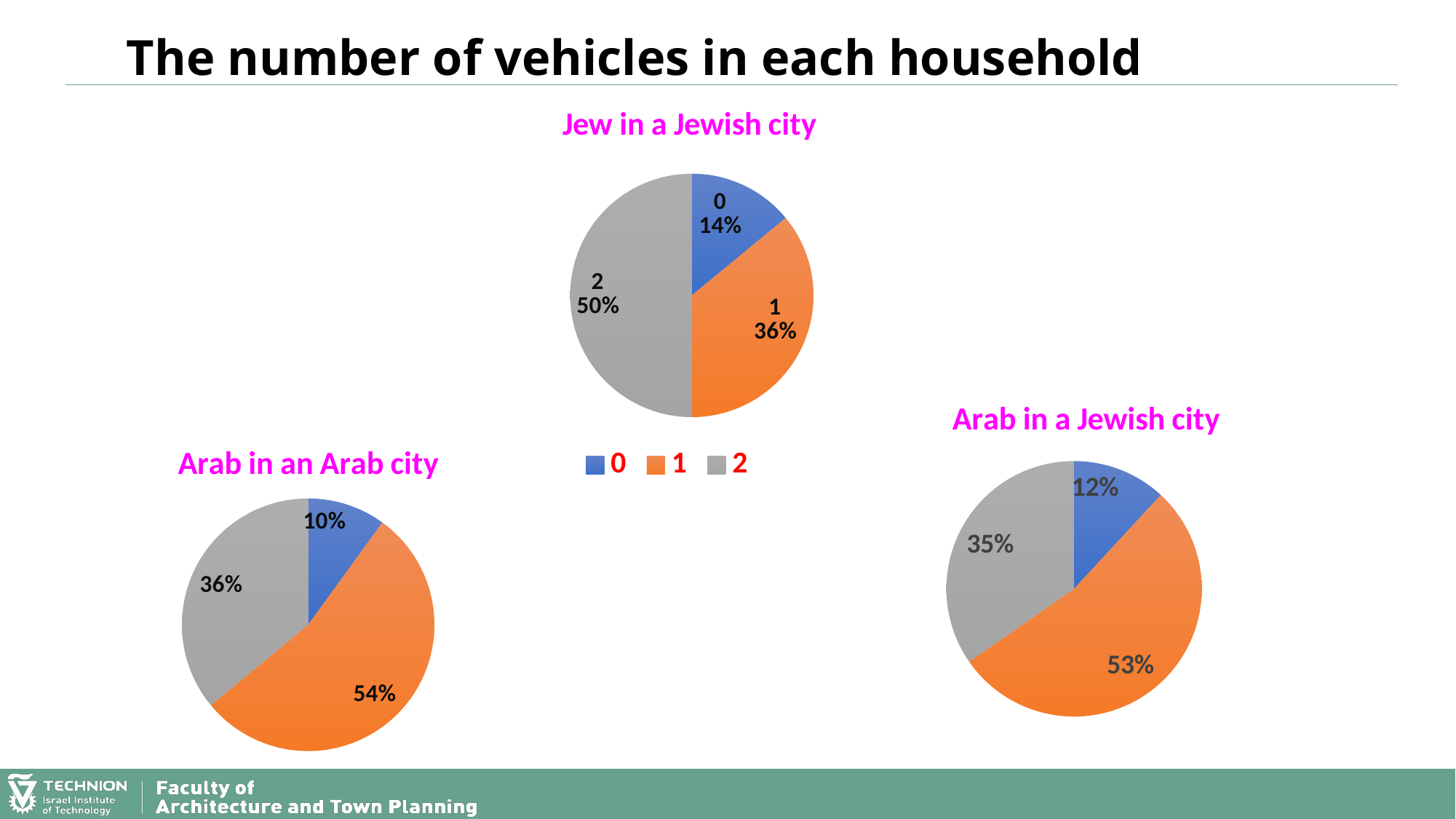
How many pie charts are shown on the slide? 3 How many categories does the legend list? 3 Which is larger: the share of households with 0 vehicles in the 'Jew in a Jewish city' chart or in the 'Arab in an Arab city' chart? Jew in a Jewish city In the 'Arab in a Jewish city' pie chart, which category has the largest share? 1 What kind of chart is used on this slide? Pie chart In the 'Arab in an Arab city' pie chart, which category has the smallest share? 0 In the 'Jew in a Jewish city' pie chart, what is the difference between the share for 2 vehicles and the share for 1 vehicle? 14% In the 'Jew in a Jewish city' pie chart, what share of households have 2 vehicles? 50% In the 'Arab in a Jewish city' pie chart, what share of households have 2 vehicles (grey slice)? 35% In the 'Jew in a Jewish city' pie chart, what share of households have 0 vehicles? 14% In the 'Jew in a Jewish city' pie chart, which category has the largest share? 2 In the 'Arab in an Arab city' pie chart, what share of households have 1 vehicle (orange slice)? 54%